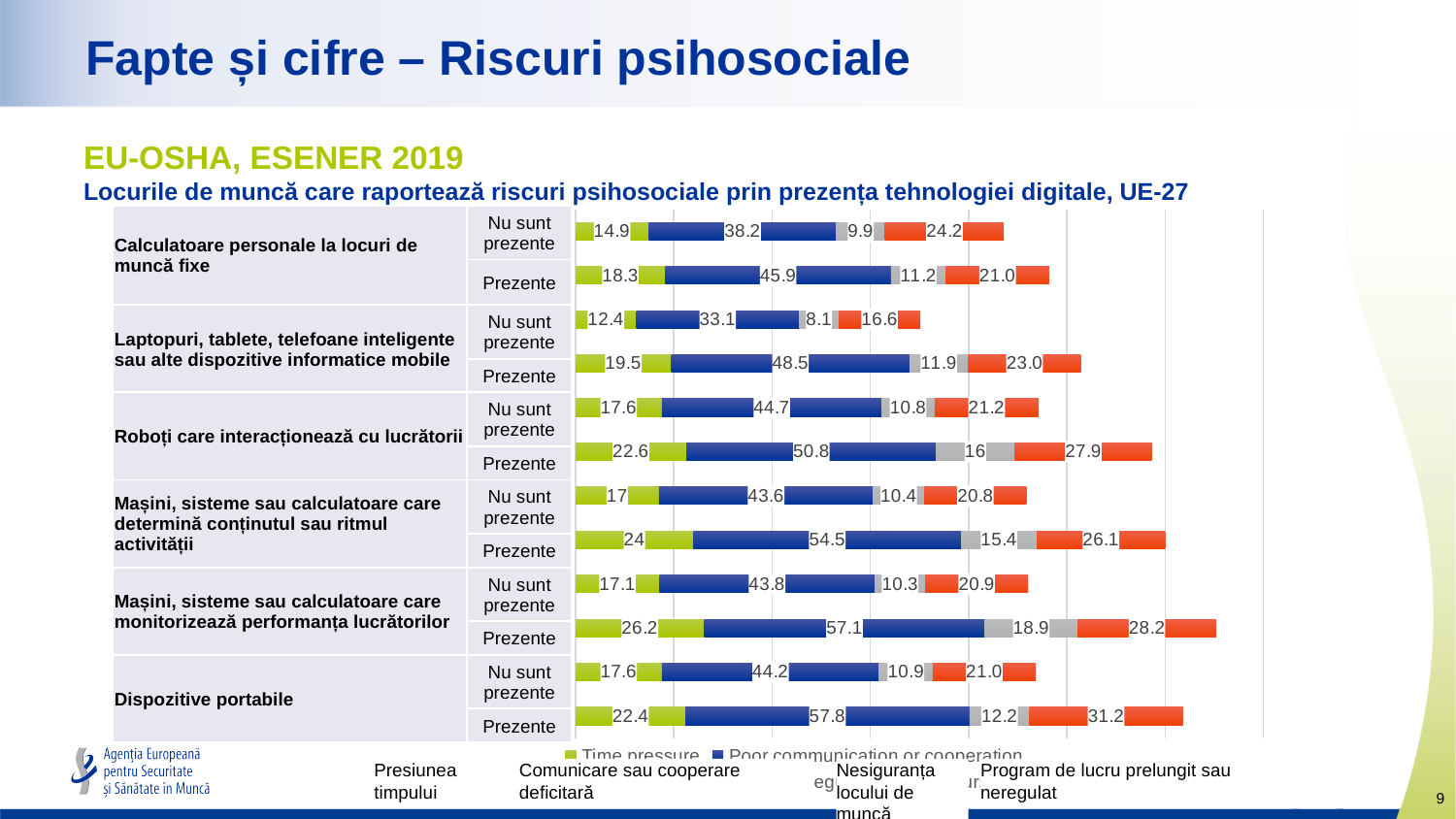
What is the value for 'Nesiguranța locului de muncă' for 'Mașini, sisteme sau calculatoare care monitorizează performanța lucrătorilor' when they are 'Prezente'? 18.9 What is the difference in 'Comunicare sau cooperare deficitară' between 'Prezente' and 'Nu sunt prezente' for 'Dispozitive portabile'? 13.6 What is the value for 'Presiunea timpului' for 'Laptopuri, tablete, telefoane inteligente sau alte dispozitive informatice mobile' when they are 'Nu sunt prezente'? 12.4 What is the total of the stacked bar for 'Laptopuri, tablete, telefoane inteligente sau alte dispozitive informatice mobile' when they are 'Nu sunt prezente'? 70.2 Which bar has the lowest value for 'Comunicare sau cooperare deficitară'? Laptopuri, tablete, telefoane inteligente sau alte dispozitive informatice mobile, Nu sunt prezente What is the value for 'Program de lucru prelungit sau neregulat' for 'Roboți care interacționează cu lucrătorii' when they are 'Prezente'? 27.9 For 'Calculatoare personale la locuri de muncă fixe', is 'Program de lucru prelungit sau neregulat' larger when they are 'Prezente' or 'Nu sunt prezente'? Nu sunt prezente How many series does the legend list? 4 How many bars are plotted in the chart? 12 What kind of chart is shown on the slide? Stacked bar chart Which bar has the highest value for 'Comunicare sau cooperare deficitară'? Dispozitive portabile, Prezente What is the value for 'Comunicare sau cooperare deficitară' for 'Dispozitive portabile' when they are 'Prezente'? 57.8